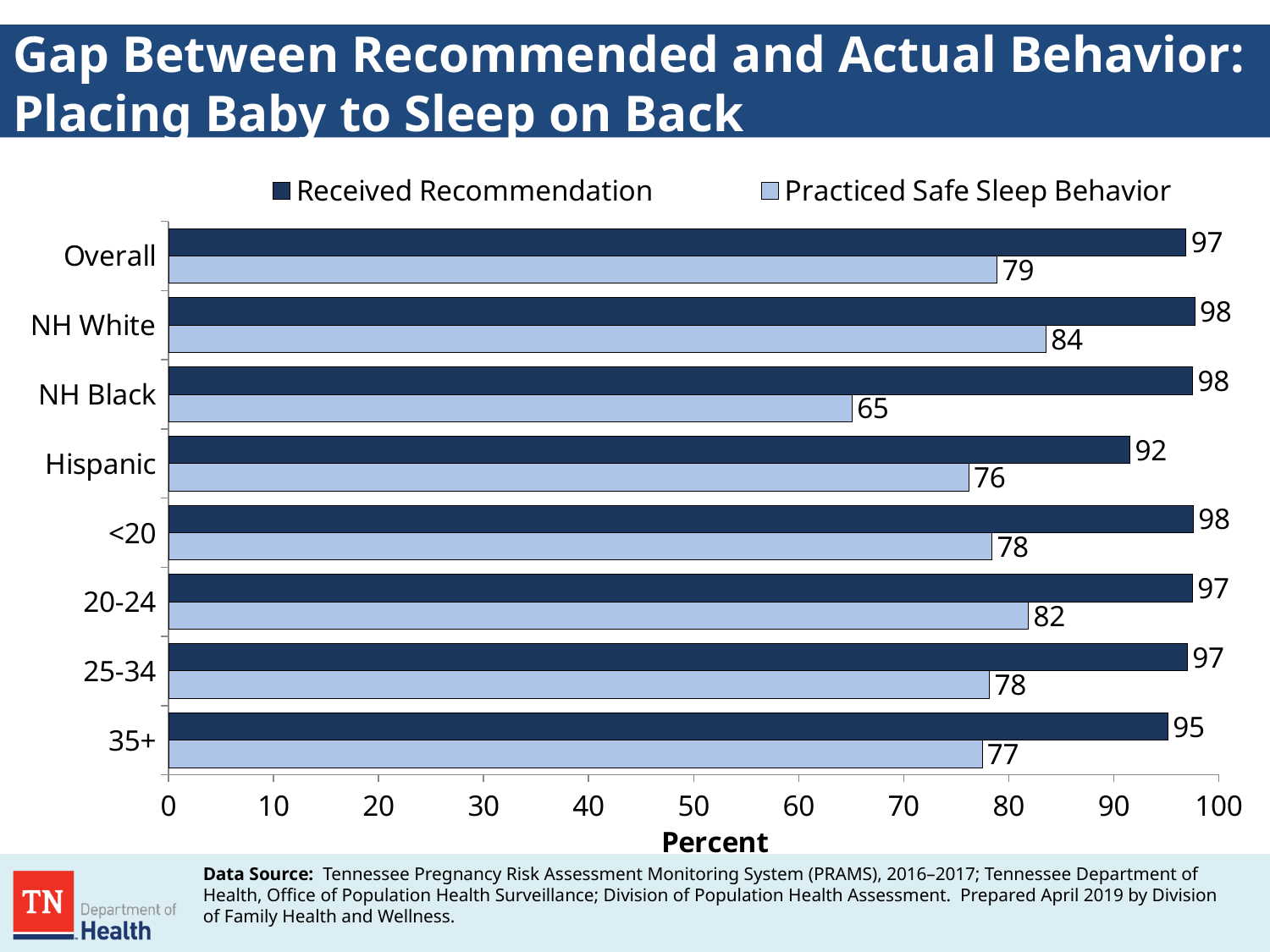
What is the difference between Received Recommendation and Practiced Safe Sleep Behavior for Overall? 18 Which is larger: Practiced Safe Sleep Behavior for NH White or for Hispanic? NH White Which category has the lowest value for Received Recommendation? Hispanic What is the value for Received Recommendation for Hispanic? 92 How many categories are shown on the chart? 8 What is the value for Practiced Safe Sleep Behavior for NH Black? 65 How many series does the legend list? 2 Which category has the highest value for Practiced Safe Sleep Behavior? NH White Which category has the lowest value for Practiced Safe Sleep Behavior? NH Black What is the value for Practiced Safe Sleep Behavior for 20-24? 82 What is the difference between Received Recommendation and Practiced Safe Sleep Behavior for NH Black? 33 What kind of chart is shown on the slide? Bar chart